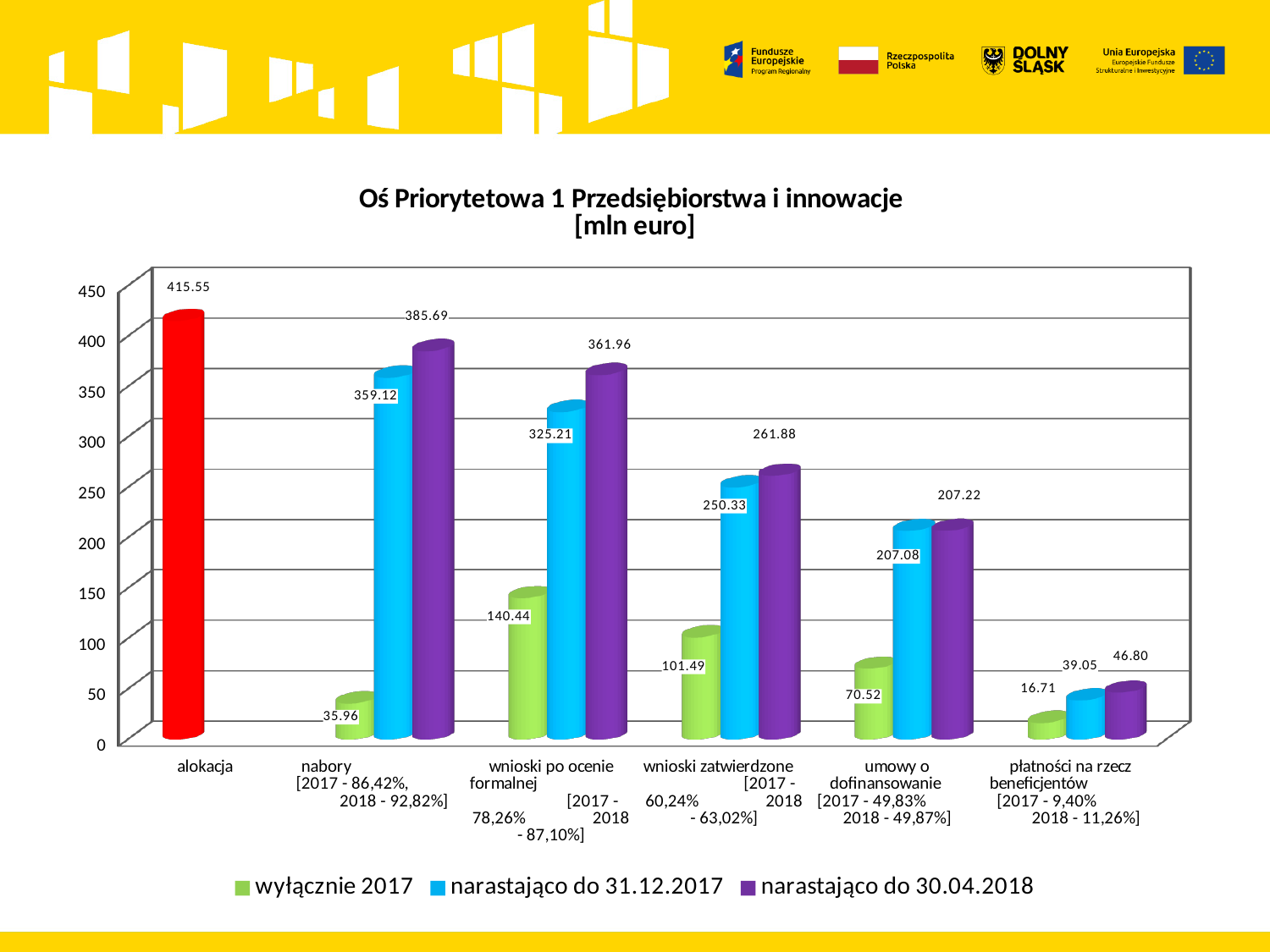
What is the difference between the 'narastająco do 30.04.2018' and 'narastająco do 31.12.2017' values for wnioski zatwierdzone? 11.55 Which is larger for płatności na rzecz beneficjentów: the 'narastająco do 31.12.2017' value or the 'narastająco do 30.04.2018' value? narastająco do 30.04.2018 What is the value of the alokacja bar? 415.55 Which category has the lowest value for the 'wyłącznie 2017' series? płatności na rzecz beneficjentów What unit is given in the chart title? mln euro What type of chart is shown on the slide? bar chart How many categories are shown on the x axis? 6 What is the value for 'narastająco do 30.04.2018' in the nabory category? 385.69 Which category has the highest value for the 'narastająco do 30.04.2018' series? nabory What is the value for 'wyłącznie 2017' in the wnioski po ocenie formalnej category? 140.44 What is the value for 'narastająco do 31.12.2017' in the umowy o dofinansowanie category? 207.08 How many series does the legend list? 3